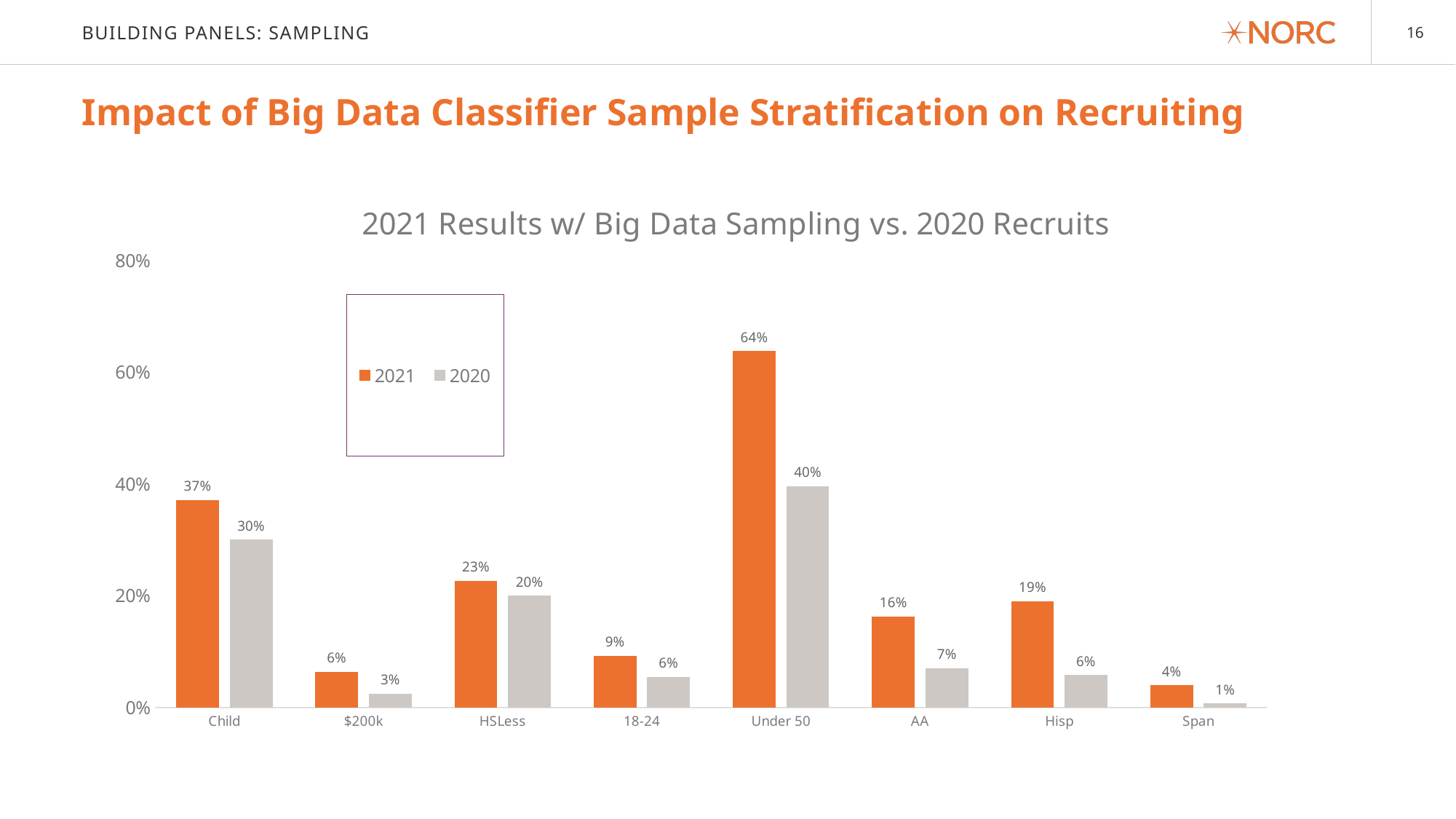
How many series does the legend list? 2 What is the 2021 value for Hisp? 19% What is the difference between the 2021 and 2020 values for AA? 9% How many categories are shown on the x axis? 8 What is the 2020 value for Child? 30% What is the difference between the 2021 and 2020 values for Under 50? 24% What is the 2021 value for Under 50? 64% What kind of chart is shown on the slide? Bar chart Which category has the lowest 2020 value? Span Which is larger, the 2021 value for HSLess or the 2021 value for Hisp? HSLess Is the 2020 value for Under 50 greater or less than 60%? less Which category has the highest 2021 value? Under 50